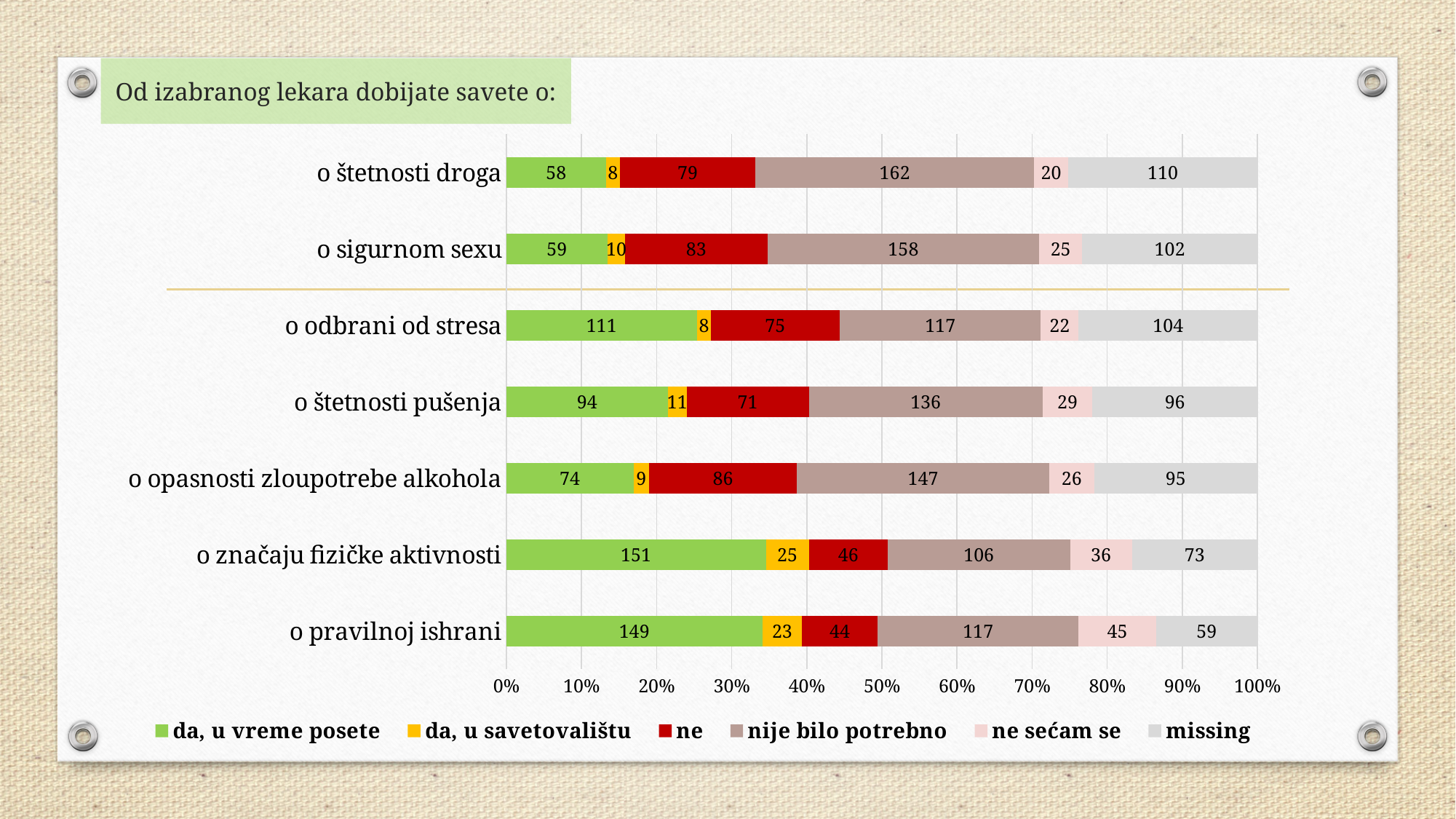
What is the 'missing' value for 'o značaju fizičke aktivnosti'? 73 Which is larger: the 'ne sećam se' value for 'o pravilnoj ishrani' or for 'o značaju fizičke aktivnosti'? o pravilnoj ishrani Which category has the lowest value for 'ne'? o pravilnoj ishrani How many categories are plotted on the chart? 7 What is the value of 'da, u vreme posete' for 'o pravilnoj ishrani'? 149 Which category has the highest value for 'da, u vreme posete'? o značaju fizičke aktivnosti What is the title of the chart? Od izabranog lekara dobijate savete o: What is the value of 'nije bilo potrebno' for 'o štetnosti droga'? 162 How many series does the legend list? 6 What is the difference between the 'ne' values for 'o opasnosti zloupotrebe alkohola' and 'o štetnosti pušenja'? 15 What is the total of the stacked bar for 'o odbrani od stresa'? 437 What type of chart is shown on the slide? stacked bar chart